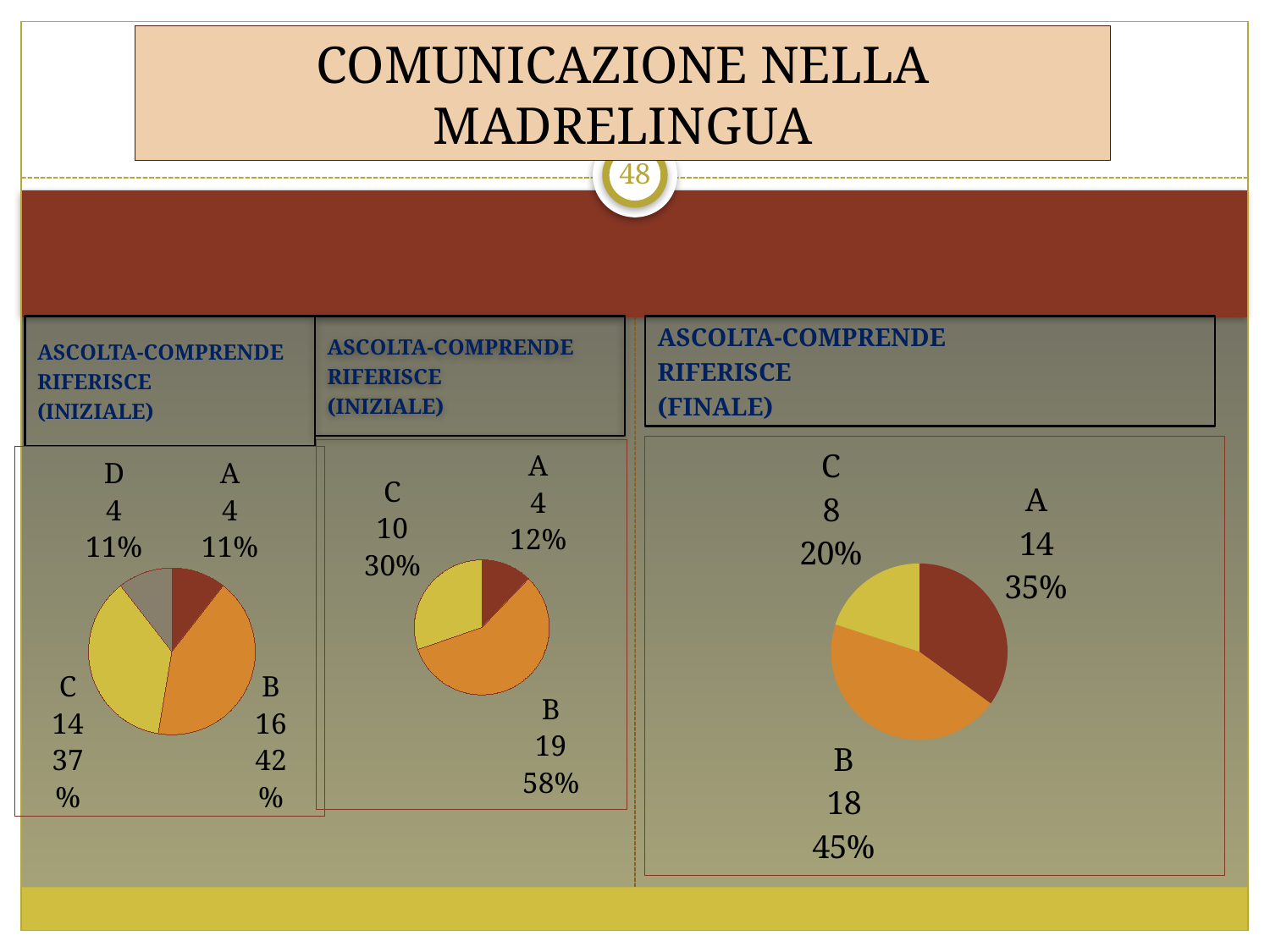
How many slices does the left pie chart have? 4 In the right pie chart, which is larger, A or C? A In the right pie chart, what share of the pie does B represent? 45% In the middle pie chart, what share of the pie does B represent? 58% What type of chart is used on the right side of the slide? Pie chart In the right pie chart (ASCOLTA-COMPRENDE RIFERISCE FINALE), what is the value for A? 14 In the middle pie chart, which category has the smallest slice? A In the left pie chart, which category has the largest slice? B In the left pie chart (ASCOLTA-COMPRENDE RIFERISCE INIZIALE), what is the value for B? 16 In the middle pie chart, what is the difference between the values for B and C? 9 In the middle pie chart (ASCOLTA-COMPRENDE RIFERISCE INIZIALE), what is the value for C? 10 In the left pie chart, what share of the pie does C represent? 37%